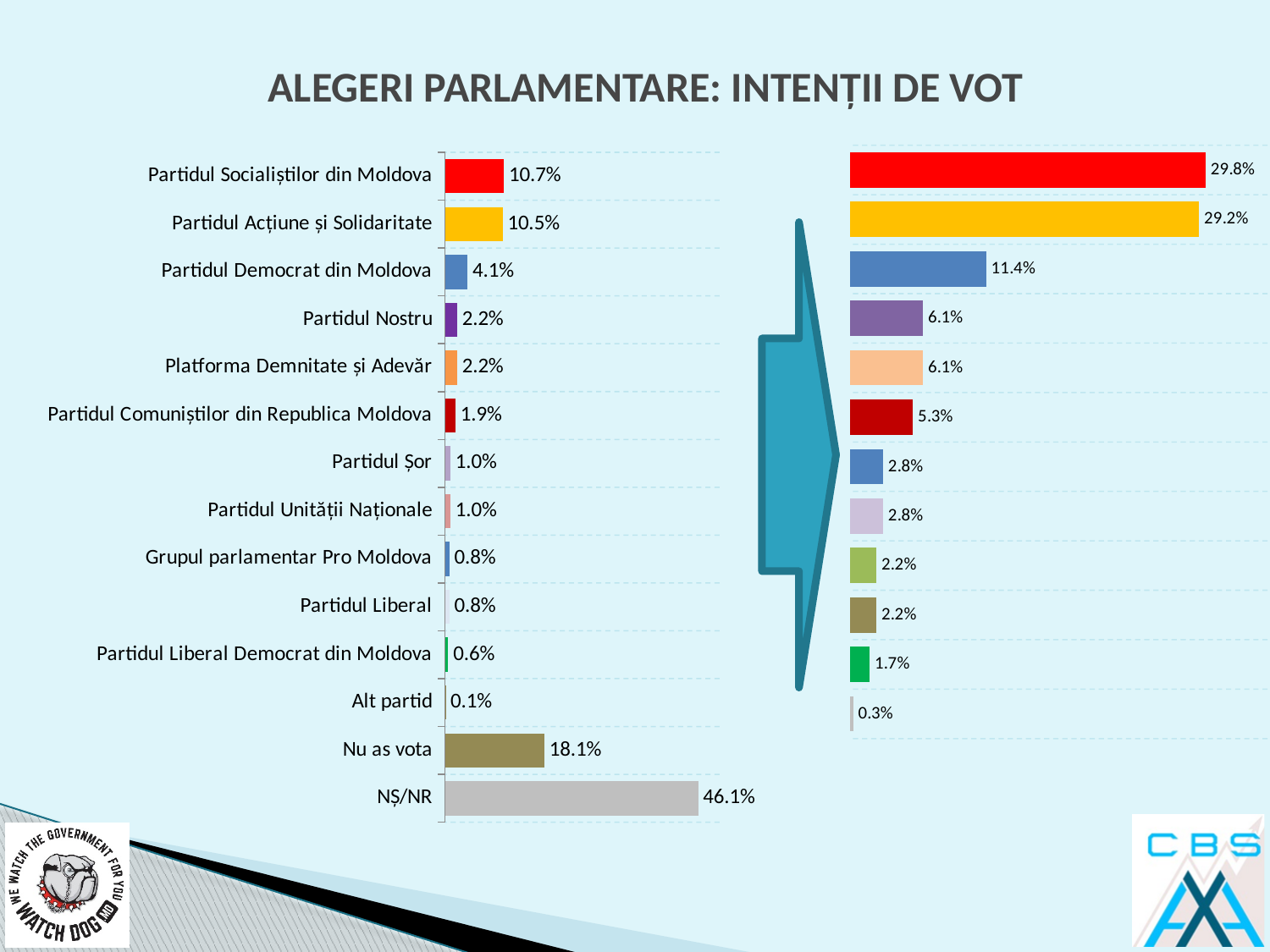
On the right chart, what is the value of the third bar from the top (blue)? 11.4% What kind of chart is the left chart? bar chart On the left chart, which category has the lowest value? Alt partid On the left chart, which is larger: the value for Partidul Democrat din Moldova or the value for Partidul Nostru? Partidul Democrat din Moldova What is the title of the slide? ALEGERI PARLAMENTARE: INTENȚII DE VOT On the left chart, what is the difference between the values for Partidul Socialiștilor din Moldova and Partidul Acțiune și Solidaritate? 0.2% How many categories does the left chart show? 14 On the left chart, what is the value for Partidul Democrat din Moldova? 4.1% On the left chart, which category has the highest value? NȘ/NR On the right chart, what is the value of the top (red) bar? 29.8% On the left chart, what is the value for Partidul Socialiștilor din Moldova? 10.7% On the left chart, what is the value for Nu as vota? 18.1%